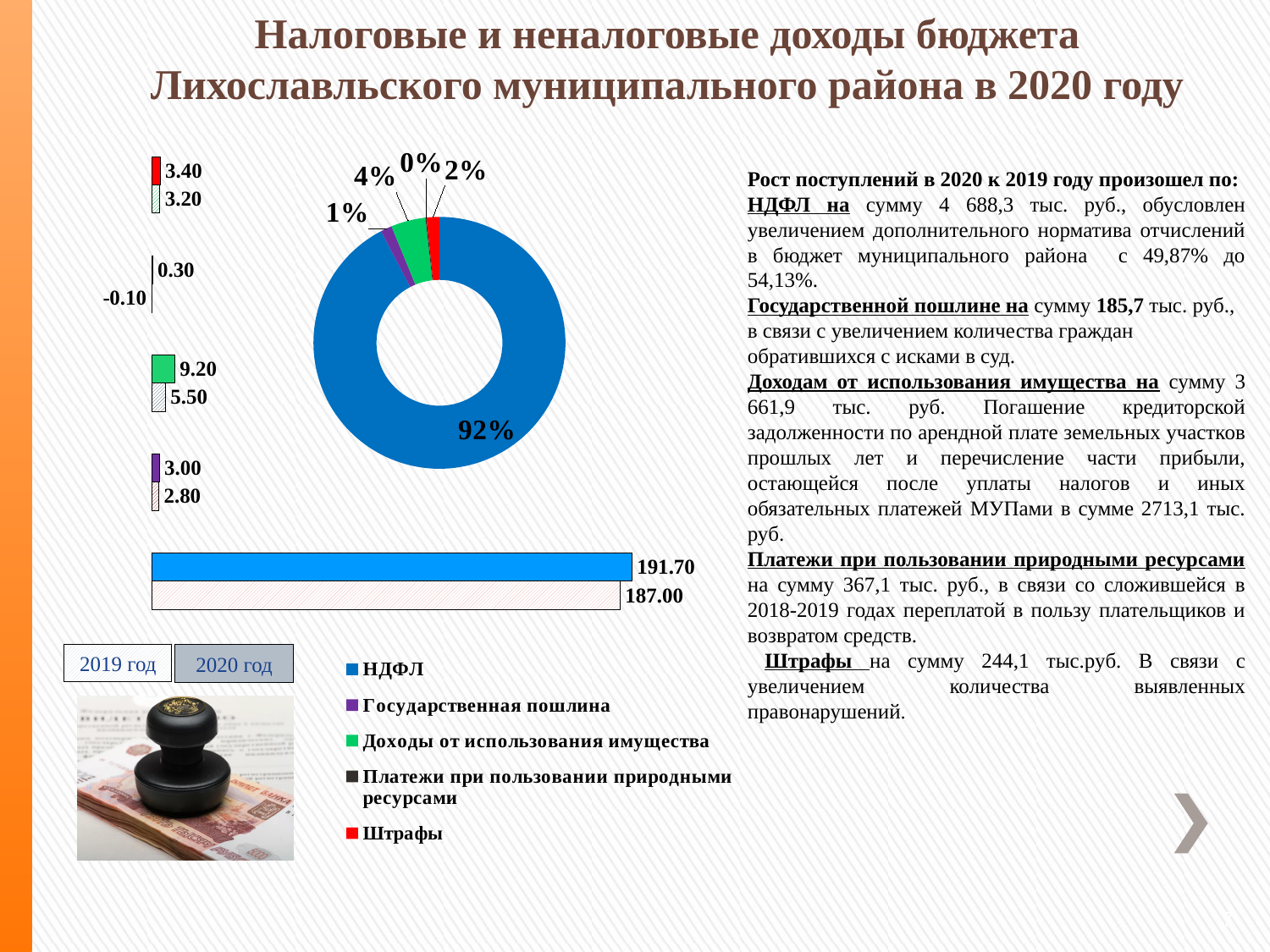
Which two years are compared in the small bar charts on the left of the slide? 2019 год and 2020 год In the red bar chart at the top left (Штрафы), what is the value for 2020 год? 3.40 In the doughnut chart, what share is labelled for the green slice (Доходы от использования имущества)? 4% How many categories does the legend of the doughnut chart list? 5 In the doughnut chart, which category has the largest share? НДФЛ In the bar chart at the bottom left for НДФЛ, what is the value for 2019 год? 187.00 In the green bar chart (Доходы от использования имущества), which year has the larger value, 2019 год or 2020 год? 2020 год In the green bar chart (Доходы от использования имущества), what is the value for 2019 год? 5.50 What kind of chart is the large chart in the centre of the slide showing 92%? doughnut (pie) chart In the bar chart at the bottom left for НДФЛ, what is the value for 2020 год? 191.70 In the bar chart for НДФЛ, what is the difference between the 2020 год and 2019 год values? 4.70 In the doughnut chart, what share does the largest slice (НДФЛ) have? 92%